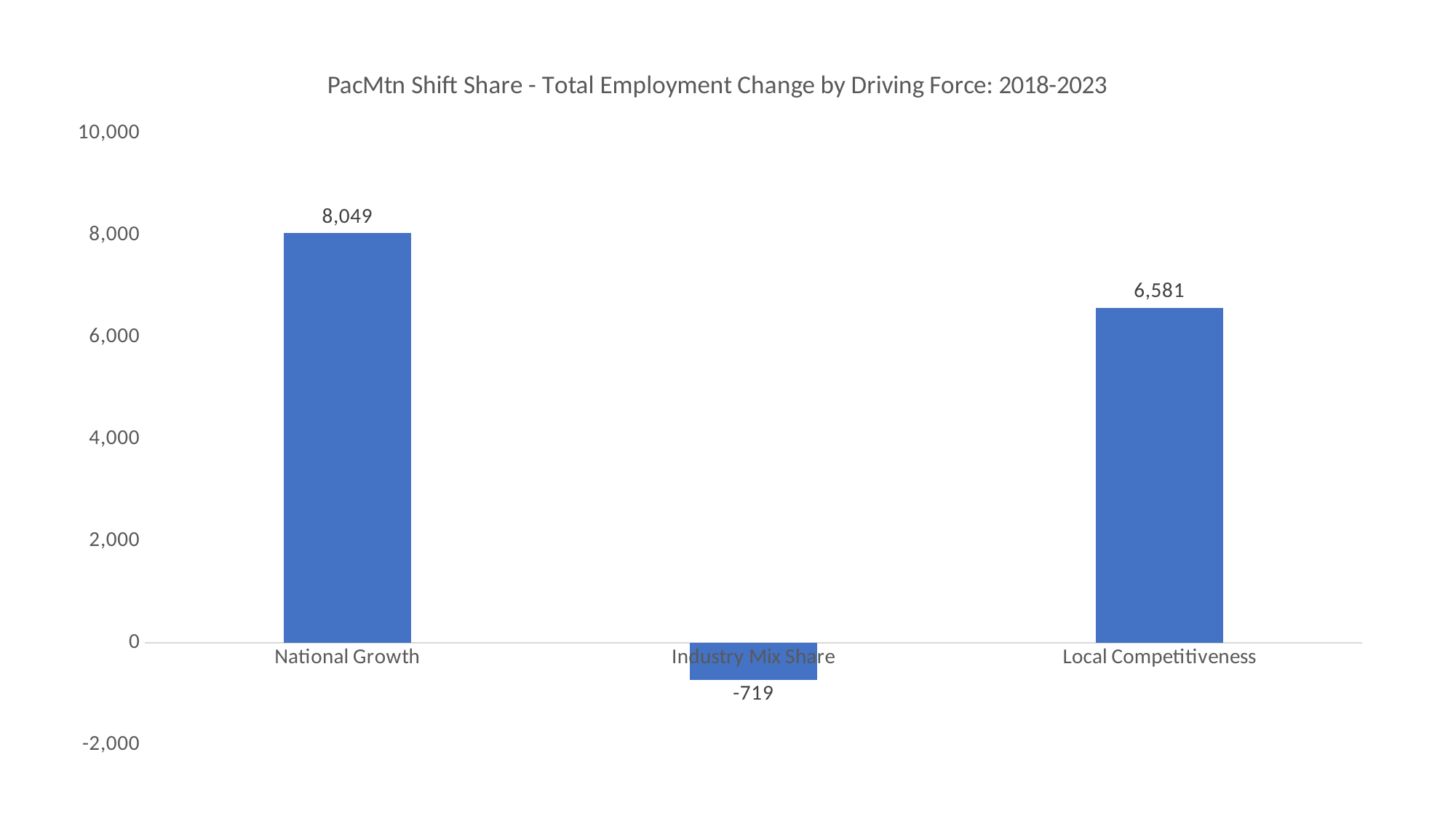
What kind of chart is shown on the slide? Bar chart Which is larger, the value for Local Competitiveness or the value for Industry Mix Share? Local Competitiveness Which driving force has the lowest value? Industry Mix Share What is the value for National Growth? 8,049 Is the value for Local Competitiveness greater or less than 6,000? greater What is the title of the chart? PacMtn Shift Share - Total Employment Change by Driving Force: 2018-2023 Which driving force has the highest value? National Growth What is the difference between the values for National Growth and Local Competitiveness? 1,468 What is the value for Industry Mix Share? -719 What is the value for Local Competitiveness? 6,581 Which category has a negative value? Industry Mix Share How many driving force categories are shown on the chart? 3